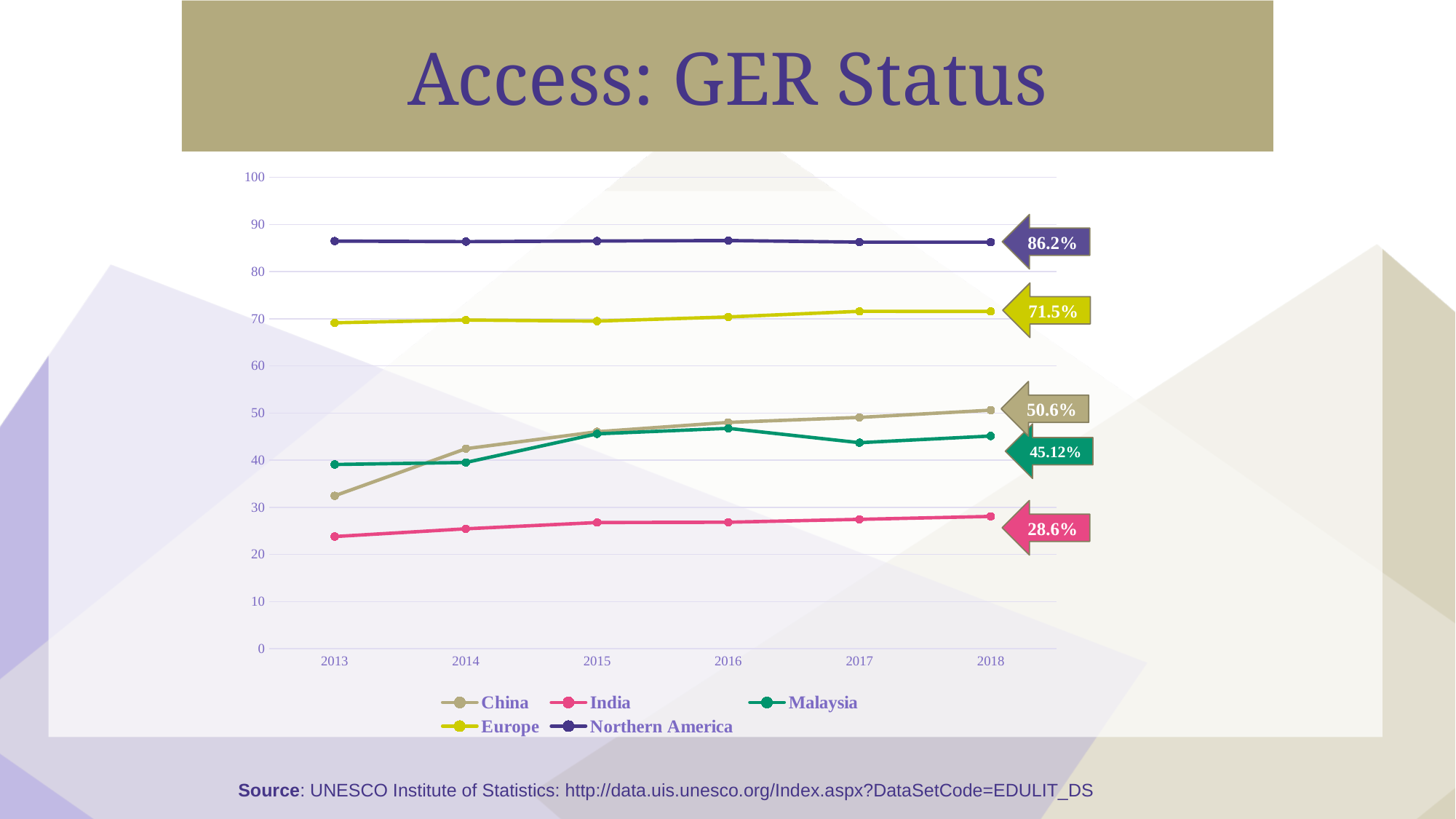
What is the 2018 value labelled for China? 50.6% How many years are shown on the x axis? 6 Which series has the highest value in 2018? Northern America What is the 2018 value labelled for Northern America? 86.2% How many series does the legend list? 5 What is the 2018 value labelled for Europe? 71.5% Is the value for China in 2013 greater or less than 40? less What is the difference between the 2018 values for Europe and China? 20.9% Which series has the lowest value in 2018? India What is the 2018 value labelled for India? 28.6% What kind of chart is shown on the slide? line chart What is the 2018 value labelled for Malaysia? 45.12%